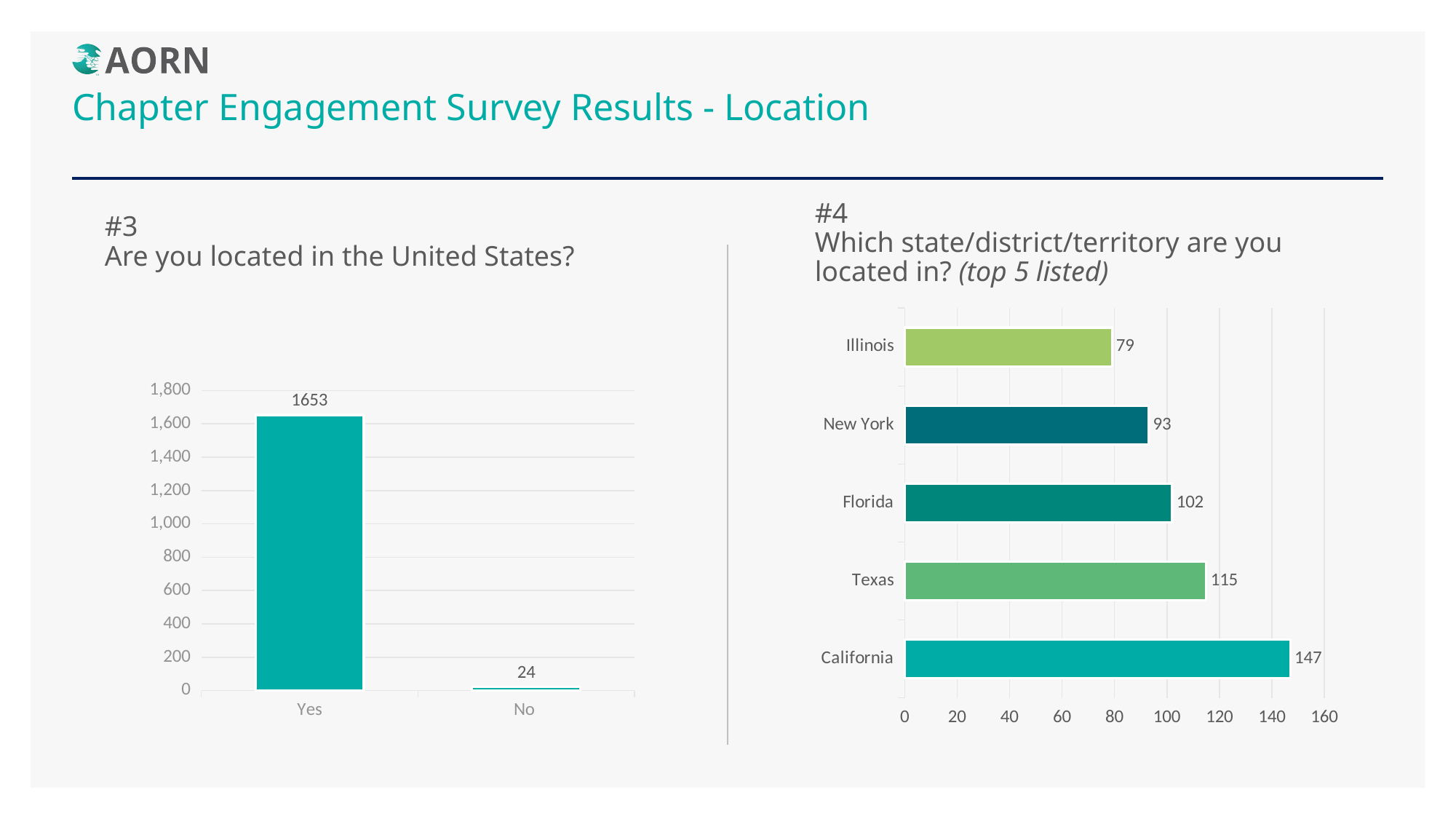
In the right chart (#4, Which state/district/territory are you located in?), what is the difference between California and Florida? 45 In the left chart (#3, Are you located in the United States?), what is the difference between the Yes and No values? 1629 In the right chart (#4, Which state/district/territory are you located in?), how many states are listed? 5 In the right chart (#4, Which state/district/territory are you located in?), which state has the lowest value? Illinois In the right chart (#4, Which state/district/territory are you located in?), what is the value for Texas? 115 In the right chart (#4, Which state/district/territory are you located in?), which is larger, Florida or New York? Florida In the left chart (#3, Are you located in the United States?), what is the value for Yes? 1653 In the right chart (#4, Which state/district/territory are you located in?), what is the value for New York? 93 In the left chart (#3, Are you located in the United States?), how many categories are shown? 2 In the left chart (#3, Are you located in the United States?), what is the value for No? 24 What kind of chart is the right chart (#4, Which state/district/territory are you located in?)? Bar chart In the right chart (#4, Which state/district/territory are you located in?), which state has the highest value? California